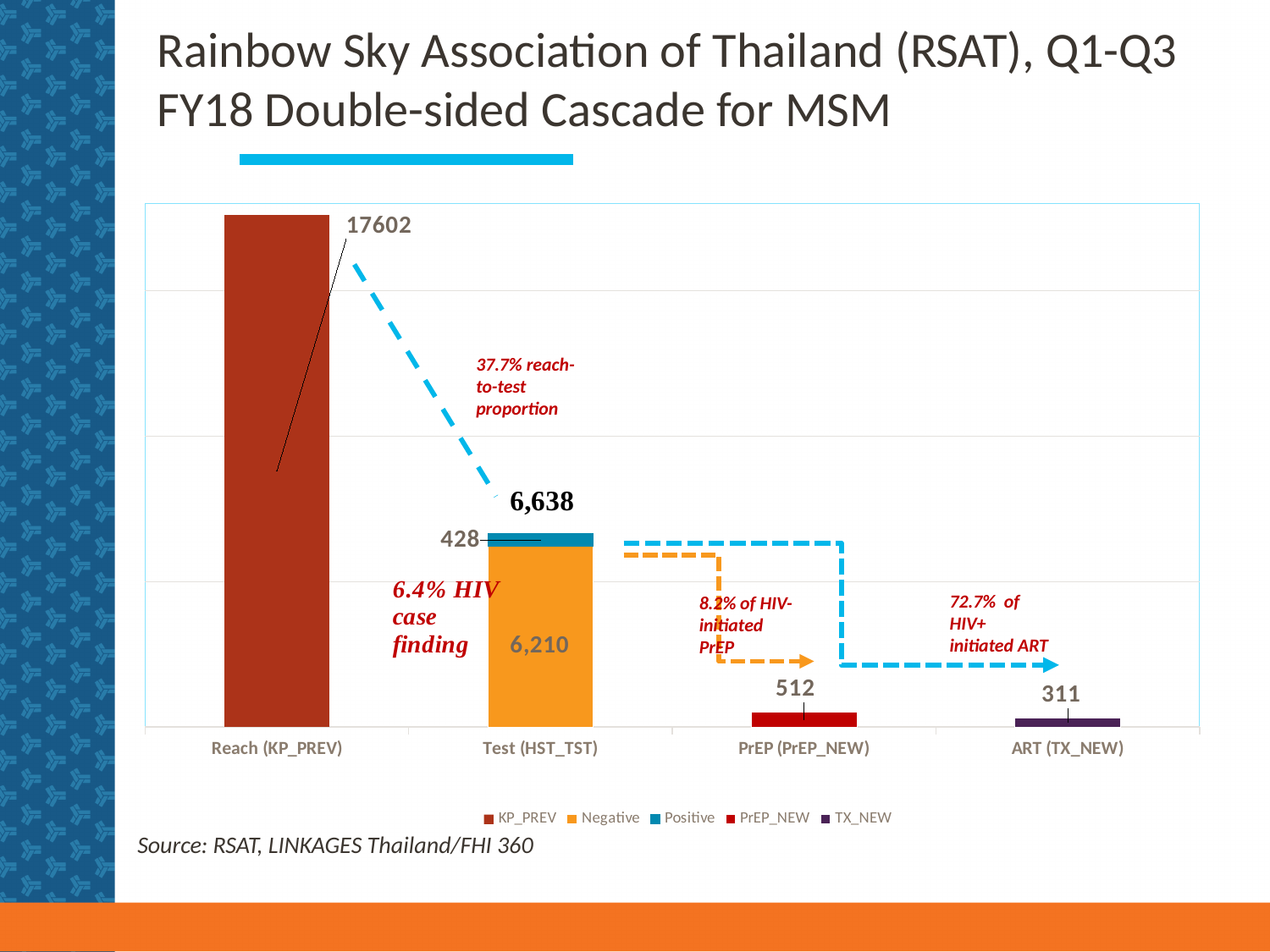
Which category has the highest value? Reach (KP_PREV) What is the Positive value in the Test (HST_TST) bar? 428 How many series does the legend list? 5 What is the total of the Test (HST_TST) stacked bar? 6,638 What is the value for Reach (KP_PREV)? 17602 What is the Negative value in the Test (HST_TST) bar? 6,210 What is the difference between the PrEP (PrEP_NEW) value and the ART (TX_NEW) value? 201 Which is larger, the Negative value or the Positive value in the Test (HST_TST) bar? Negative Which category has the lowest value? ART (TX_NEW) What is the value for PrEP (PrEP_NEW)? 512 What is the value for ART (TX_NEW)? 311 What kind of chart is shown on the slide? Bar chart